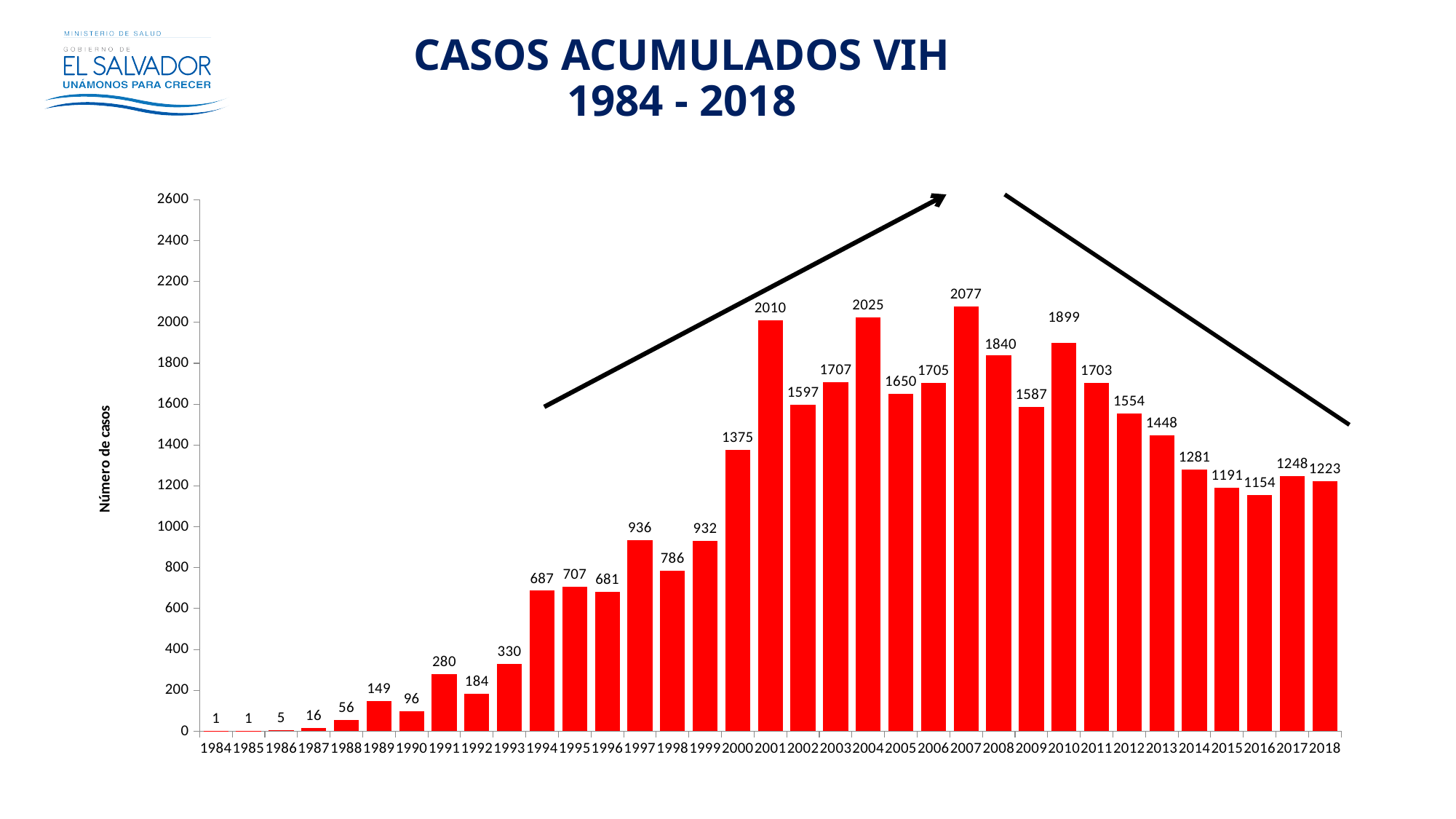
What is the title of the chart? CASOS ACUMULADOS VIH 1984 - 2018 Which year has the highest number of cases? 2007 How many years are shown on the x axis? 35 What kind of chart is this? bar chart Is the value for 2000 greater or less than 1400? less What is the number of cases for 2007? 2077 What is the label of the y axis? Número de casos What is the difference between the number of cases in 2007 and 2018? 854 What is the number of cases for 1997? 936 Which year has more cases, 2001 or 2004? 2004 What is the number of cases for 2018? 1223 Do the values rise or fall from 2010 to 2016? fall